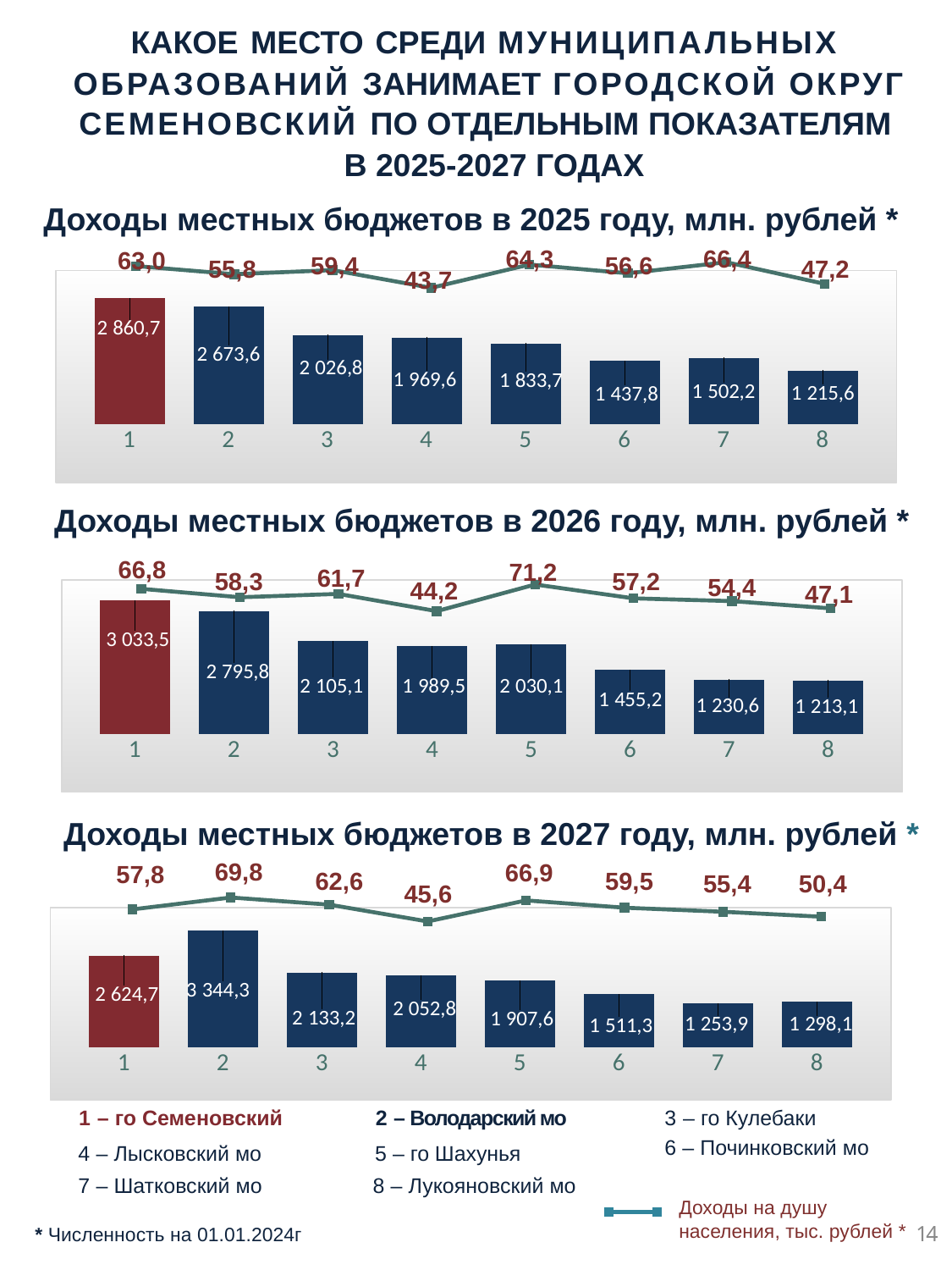
In the chart 'Доходы местных бюджетов в 2025 году, млн. рублей', which category has the lowest bar value? 8 In the chart 'Доходы местных бюджетов в 2026 году, млн. рублей', what is the per-capita income (line value) for category 4? 44,2 According to the legend at the bottom of the slide, what does the line series on the charts represent? Доходы на душу населения, тыс. рублей In the chart 'Доходы местных бюджетов в 2026 году, млн. рублей', which category has the highest per-capita income line value? 5 In the chart 'Доходы местных бюджетов в 2025 году, млн. рублей', what is the value of the bar for category 1? 2 860,7 In the chart 'Доходы местных бюджетов в 2026 году, млн. рублей', which is larger: the bar for category 4 or the bar for category 5? Category 5 How many categories are shown on the x axis of the chart 'Доходы местных бюджетов в 2027 году, млн. рублей'? 8 In the chart 'Доходы местных бюджетов в 2026 году, млн. рублей', what is the bar value for category 8? 1 213,1 In the chart 'Доходы местных бюджетов в 2027 году, млн. рублей', what is the difference between the bar values for category 2 and category 1? 719,6 In the chart 'Доходы местных бюджетов в 2027 году, млн. рублей', which category has the highest bar? 2 In the chart 'Доходы местных бюджетов в 2025 году, млн. рублей', which is larger: the bar for category 6 or the bar for category 7? Category 7 What type of chart is 'Доходы местных бюджетов в 2025 году, млн. рублей'? Bar chart with a line